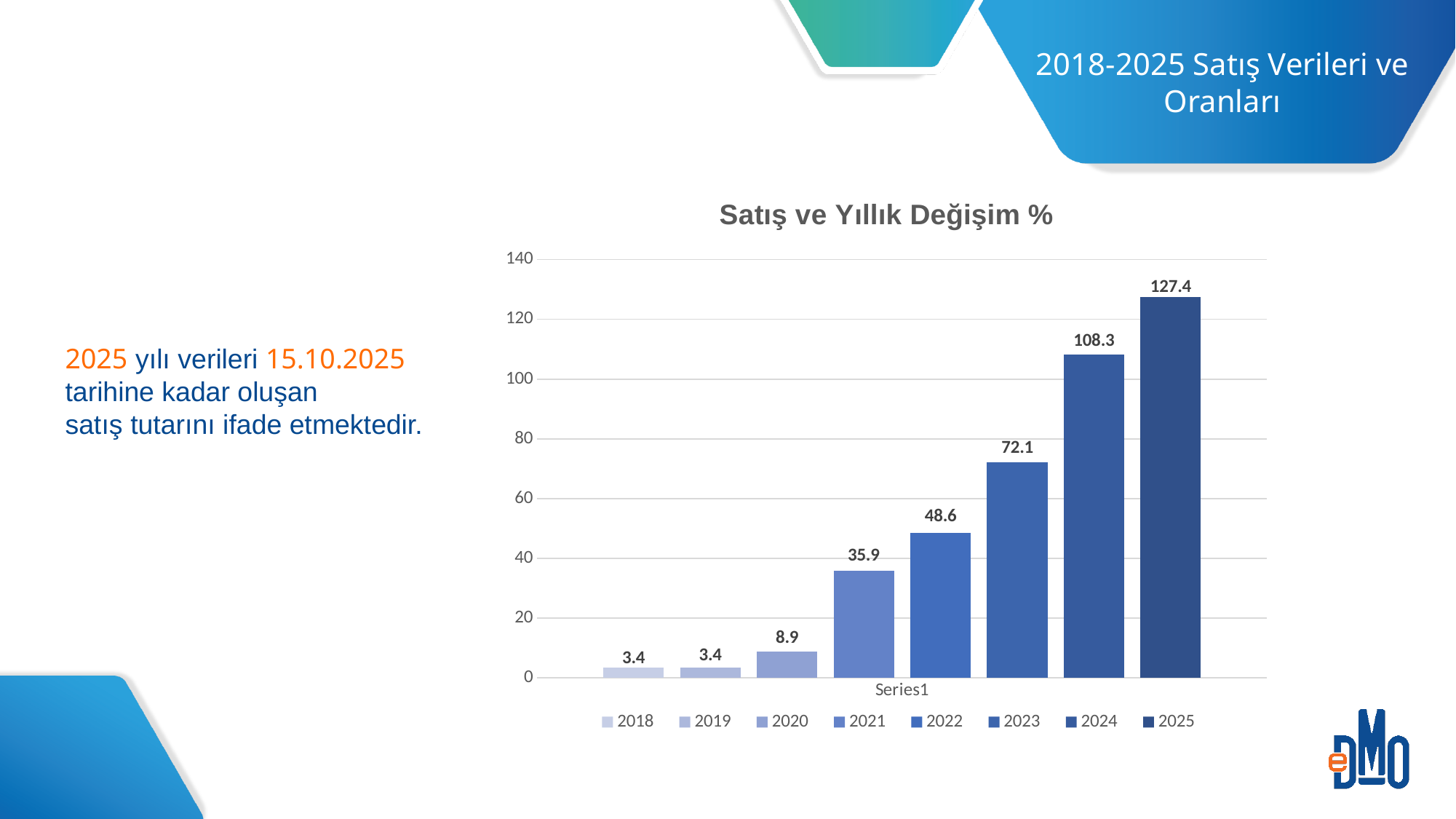
What is the difference between the values for 2025 and 2024? 19.1 What is the value shown for 2025 in the chart? 127.4 What is the title of the chart? Satış ve Yıllık Değişim % What is the difference between the values for 2023 and 2022? 23.5 Is the value for 2024 greater or less than 100? greater What kind of chart is shown on the slide? bar chart What is the value shown for 2020 in the chart? 8.9 Which is larger, the value for 2022 or the value for 2023? 2023 How many bars are plotted in the chart? 8 What is the value shown for 2021 in the chart? 35.9 Which year has the highest value in the chart? 2025 How many entries does the chart legend list? 8